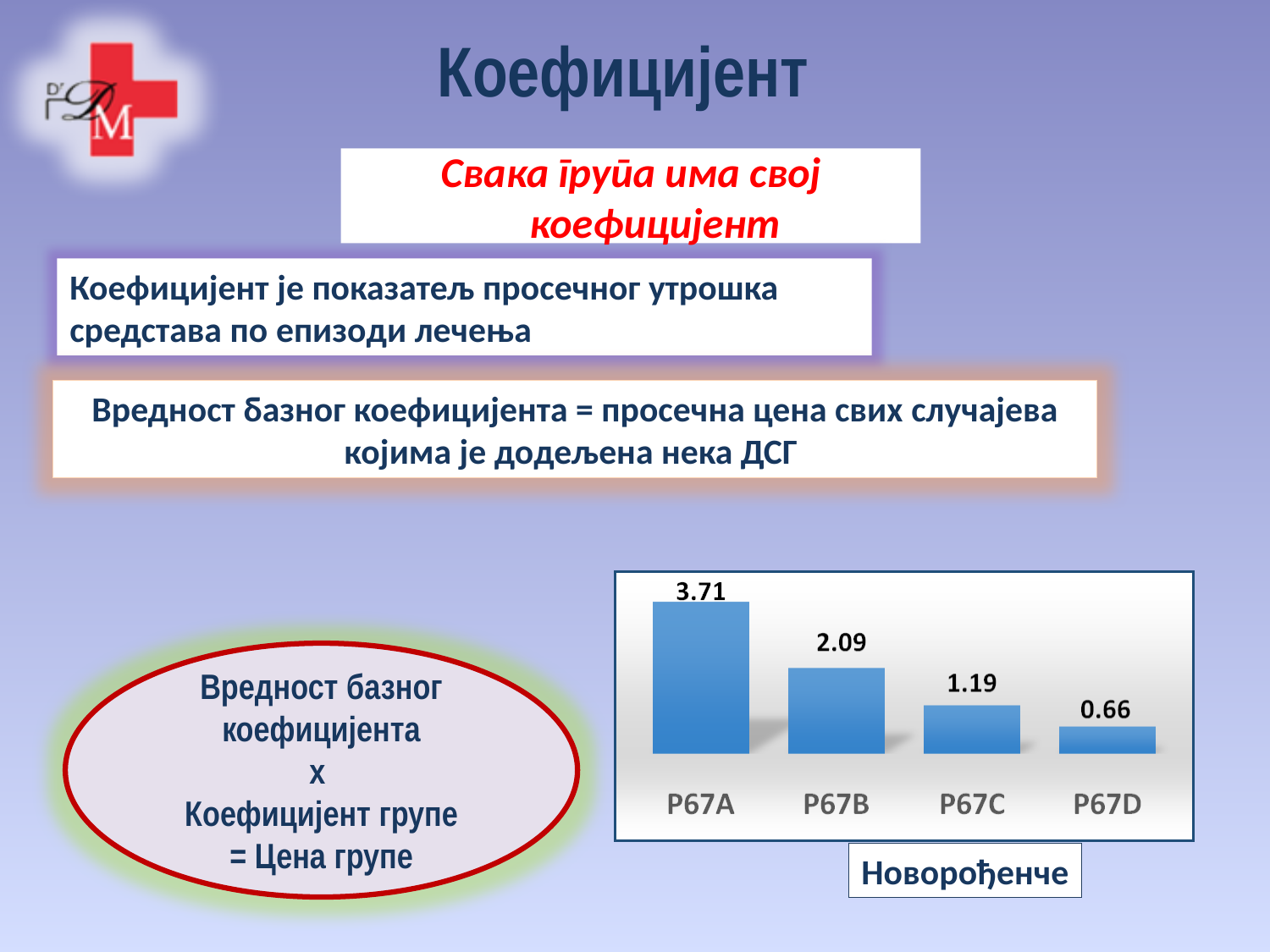
What is the value for P67D? 0.66 What is the difference between the values for P67A and P67B? 1.62 What kind of chart is shown on the slide? bar chart Which category has the lowest value? P67D What is the value for P67B? 2.09 Which is larger, the value for P67B or the value for P67C? P67B Do the values rise or fall from P67A to P67D? fall What is the value for P67C? 1.19 Which category has the highest value? P67A What is the difference between the values for P67C and P67D? 0.53 What is the value for P67A? 3.71 How many categories are shown in the chart? 4